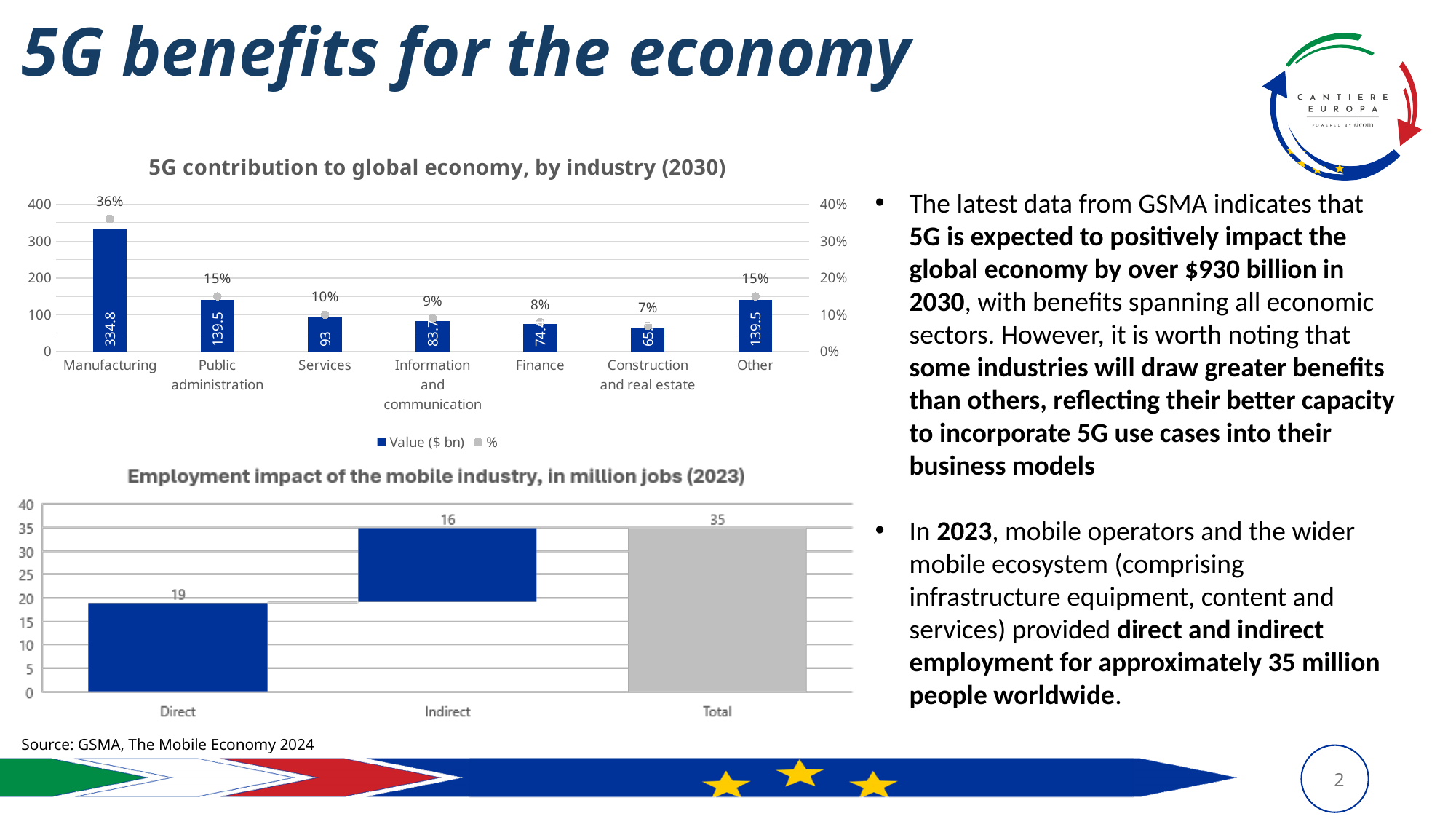
In the chart '5G contribution to global economy, by industry (2030)', how many series does the legend list? 2 In the chart '5G contribution to global economy, by industry (2030)', what is the value in $ bn for Manufacturing? 334.8 In the chart '5G contribution to global economy, by industry (2030)', what is the value in $ bn for Information and communication? 83.7 In the chart '5G contribution to global economy, by industry (2030)', what is the difference in $ bn between Manufacturing and Public administration? 195.3 In the chart '5G contribution to global economy, by industry (2030)', which industry has the lowest percentage? Construction and real estate In the chart '5G contribution to global economy, by industry (2030)', which industry has the highest value? Manufacturing In the chart '5G contribution to global economy, by industry (2030)', how many industries are shown on the x axis? 7 In the chart 'Employment impact of the mobile industry, in million jobs (2023)', what is the value for Indirect? 16 What kind of chart is 'Employment impact of the mobile industry, in million jobs (2023)'? Bar chart In the chart 'Employment impact of the mobile industry, in million jobs (2023)', which is larger, Direct or Indirect? Direct In the chart '5G contribution to global economy, by industry (2030)', is the value for Finance greater or less than 100? less In the chart '5G contribution to global economy, by industry (2030)', what percentage is shown for Services? 10%